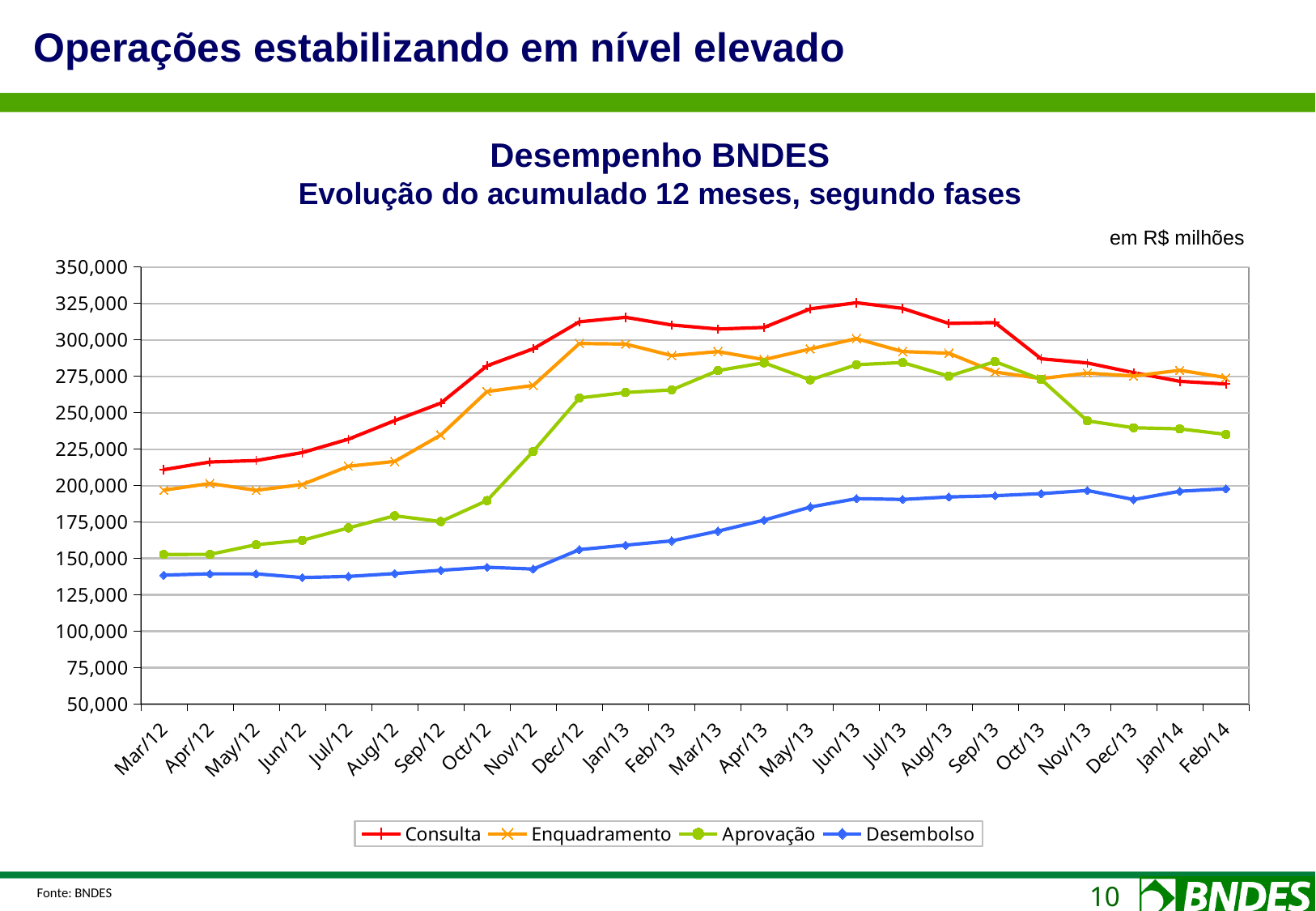
Does the Aprovação series rise or fall between Sep/13 and Feb/14? Fall In what unit are the values expressed, according to the note above the chart? em R$ milhões What kind of chart is shown on the slide? Line chart Is the value for Desembolso in Mar/12 greater or less than 150,000? less In Feb/14, which is larger: Enquadramento or Aprovação? Enquadramento How many months are plotted along the x axis? 24 In which month does the Consulta series reach its highest value? Jun/13 In which month is the Consulta series at its lowest value? Mar/12 How many series does the legend list? 4 Is the value for Consulta in Mar/12 greater or less than 200,000? greater Which series has the lowest values throughout the chart? Desembolso